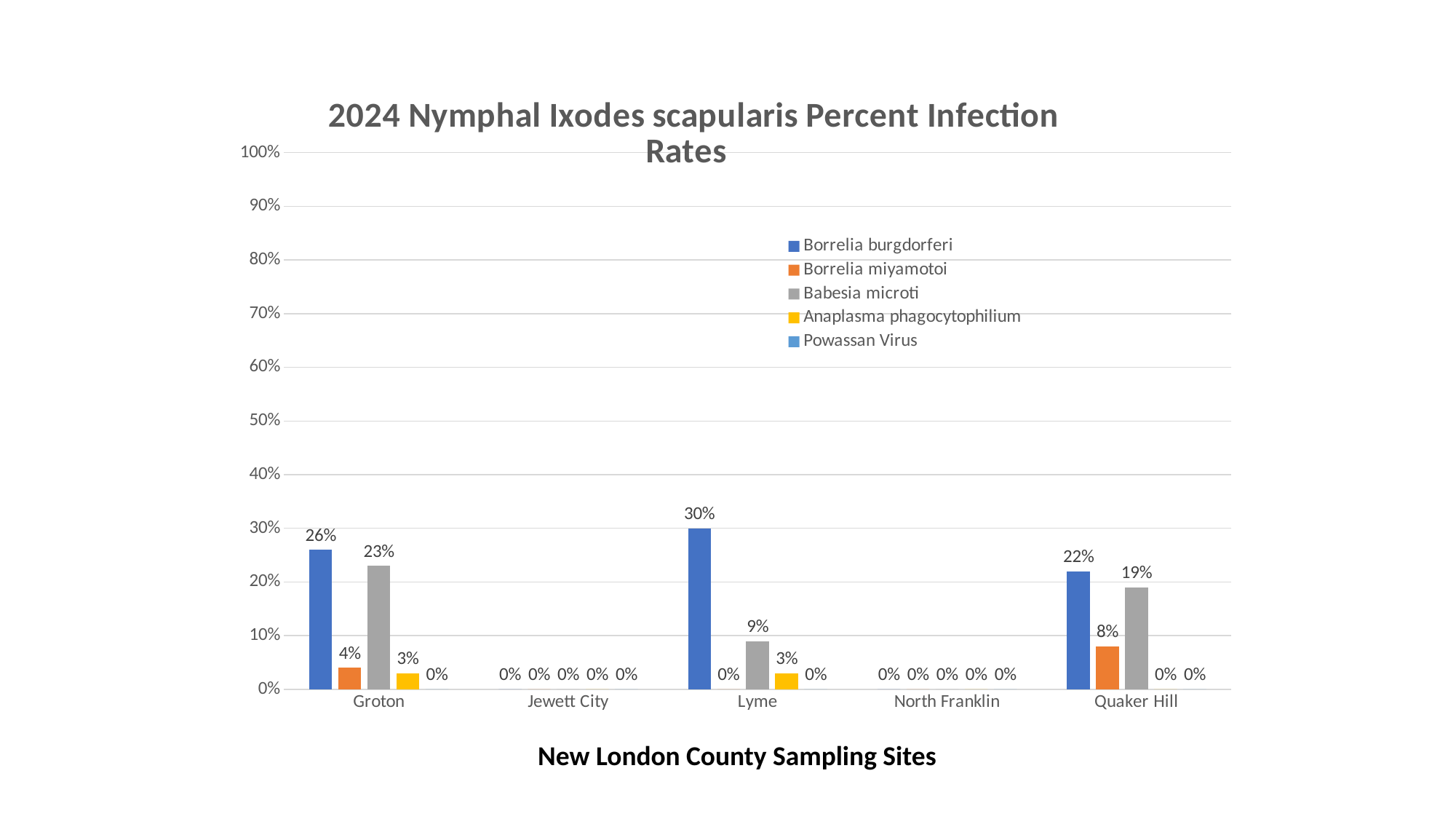
What is the Anaplasma phagocytophilium infection rate at Lyme? 3% What is the difference between the Borrelia burgdorferi rates at Lyme and Quaker Hill? 8% How many sampling sites are shown on the x axis? 5 What is the Babesia microti infection rate at Groton? 23% Which sampling site has the lowest Babesia microti infection rate among Groton, Lyme and Quaker Hill? Lyme What is the Borrelia miyamotoi infection rate at Quaker Hill? 8% Which sampling site has the highest Borrelia burgdorferi infection rate? Lyme What is the title of the chart? 2024 Nymphal Ixodes scapularis Percent Infection Rates What is the Borrelia burgdorferi infection rate at Lyme? 30% Which is larger, the Babesia microti rate at Groton or at Quaker Hill? Groton How many series does the legend list? 5 What kind of chart is shown on the slide? Bar chart